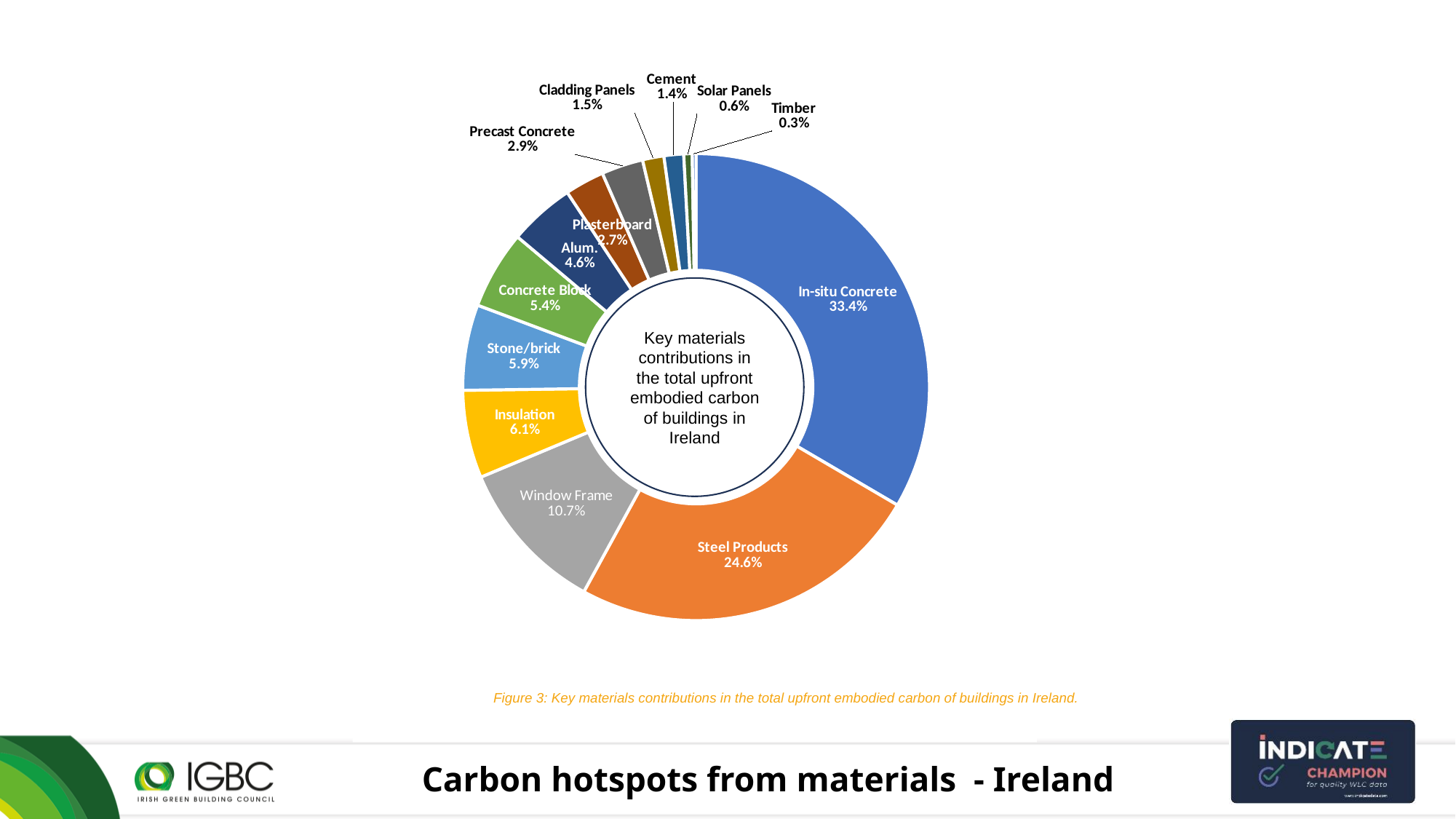
What share of the total upfront embodied carbon does In-situ Concrete contribute? 33.4% How many material categories are shown in the chart? 13 What text appears in the centre of the chart? Key materials contributions in the total upfront embodied carbon of buildings in Ireland What percentage is shown for Insulation? 6.1% Which material has the largest share of the chart? In-situ Concrete What kind of chart is shown on the slide? doughnut chart Which material has the smallest share of the chart? Timber Which has a larger share, Precast Concrete or Plasterboard? Precast Concrete What is the difference in percentage points between In-situ Concrete and Steel Products? 8.8 What percentage is shown for Steel Products? 24.6% What is the value labelled for Window Frame? 10.7% Which has a larger share, Stone/brick or Concrete Block? Stone/brick